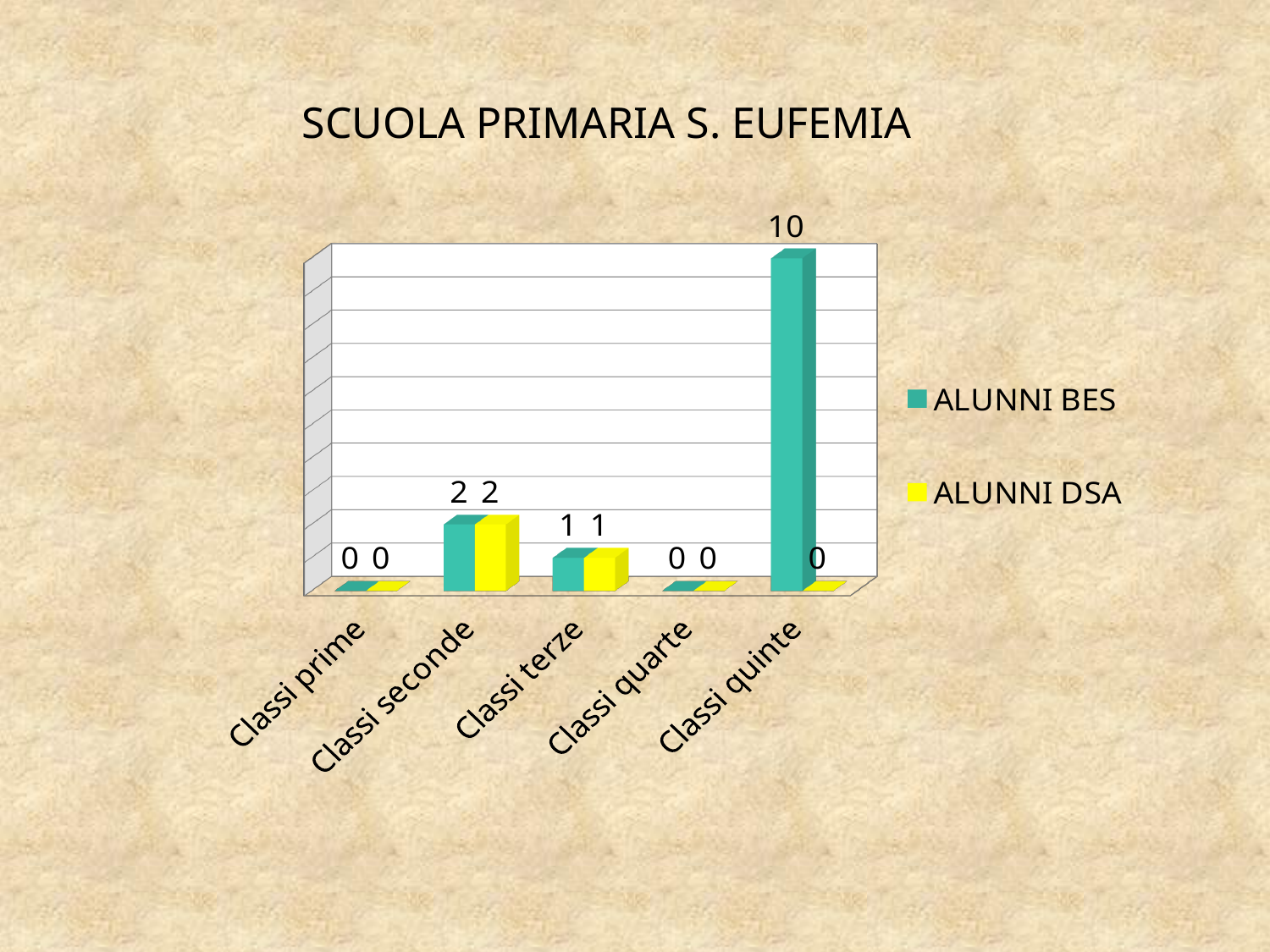
What is the difference between ALUNNI BES for Classi quinte and ALUNNI BES for Classi seconde? 8 What is the value of ALUNNI BES for Classi terze? 1 What is the value of ALUNNI DSA for Classi quinte? 0 Which colour represents ALUNNI DSA in the legend? yellow How many series does the legend list? 2 What kind of chart is shown on the slide? bar chart What is the value of ALUNNI DSA for Classi seconde? 2 How many categories are shown on the x axis? 5 What is the title of the slide? SCUOLA PRIMARIA S. EUFEMIA Which category has the highest value for ALUNNI BES? Classi quinte Which is larger: ALUNNI BES for Classi seconde or ALUNNI BES for Classi terze? Classi seconde What is the value of ALUNNI BES for Classi quinte? 10